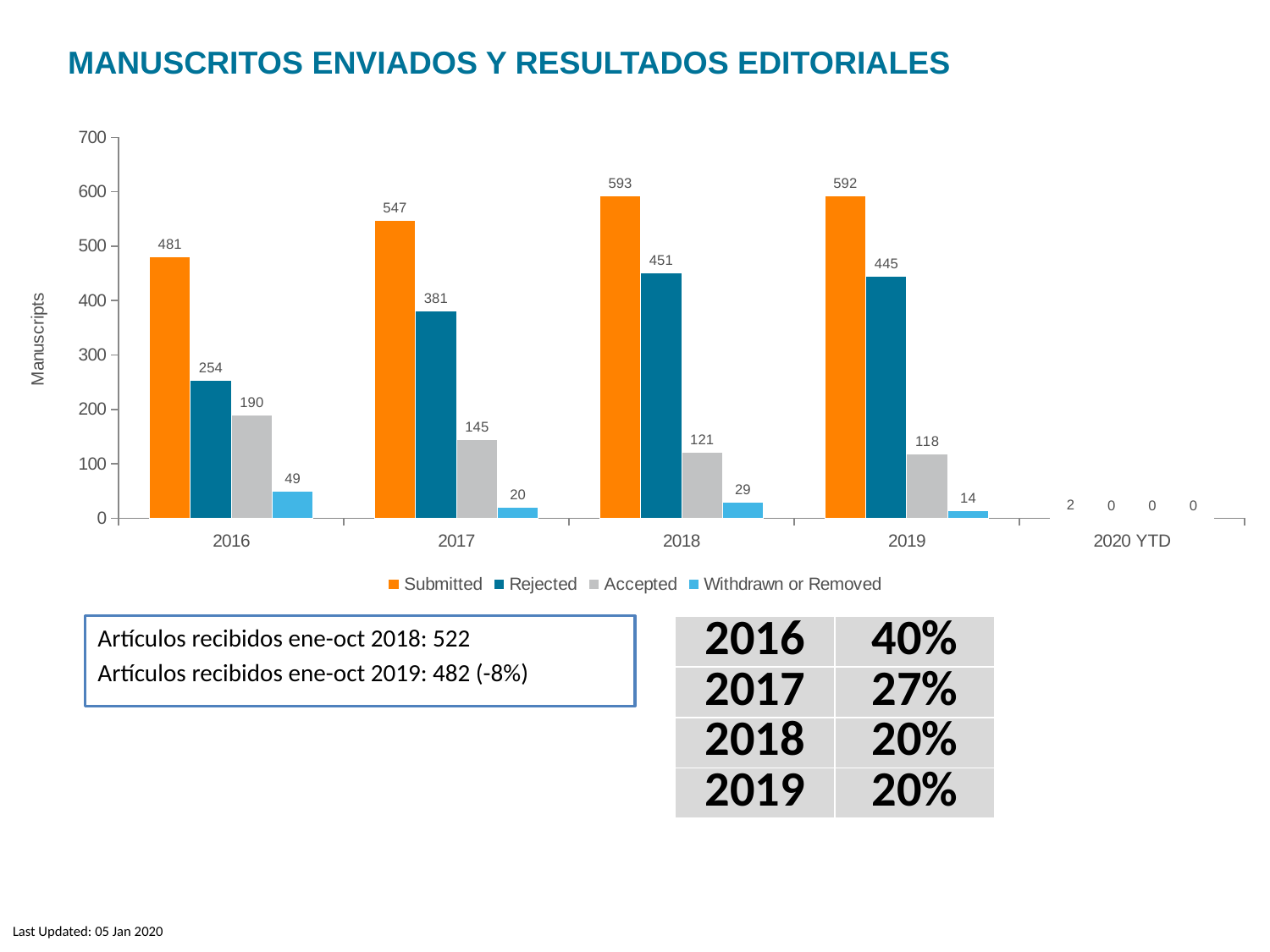
How many manuscripts were withdrawn or removed in 2019? 14 How many year categories are shown on the x axis? 5 Which year has the lowest number of rejected manuscripts, excluding 2020 YTD? 2016 How many manuscripts were accepted in 2016? 190 Were more manuscripts accepted in 2016 or in 2017? 2016 How many series does the legend list? 4 Which year has the highest number of submitted manuscripts? 2018 Do the accepted manuscript values rise or fall from 2016 to 2019? Fall What is the difference between submitted and rejected manuscripts in 2017? 166 How many manuscripts were submitted in 2018? 593 What kind of chart is shown on the slide? Bar chart What is the label of the y axis? Manuscripts